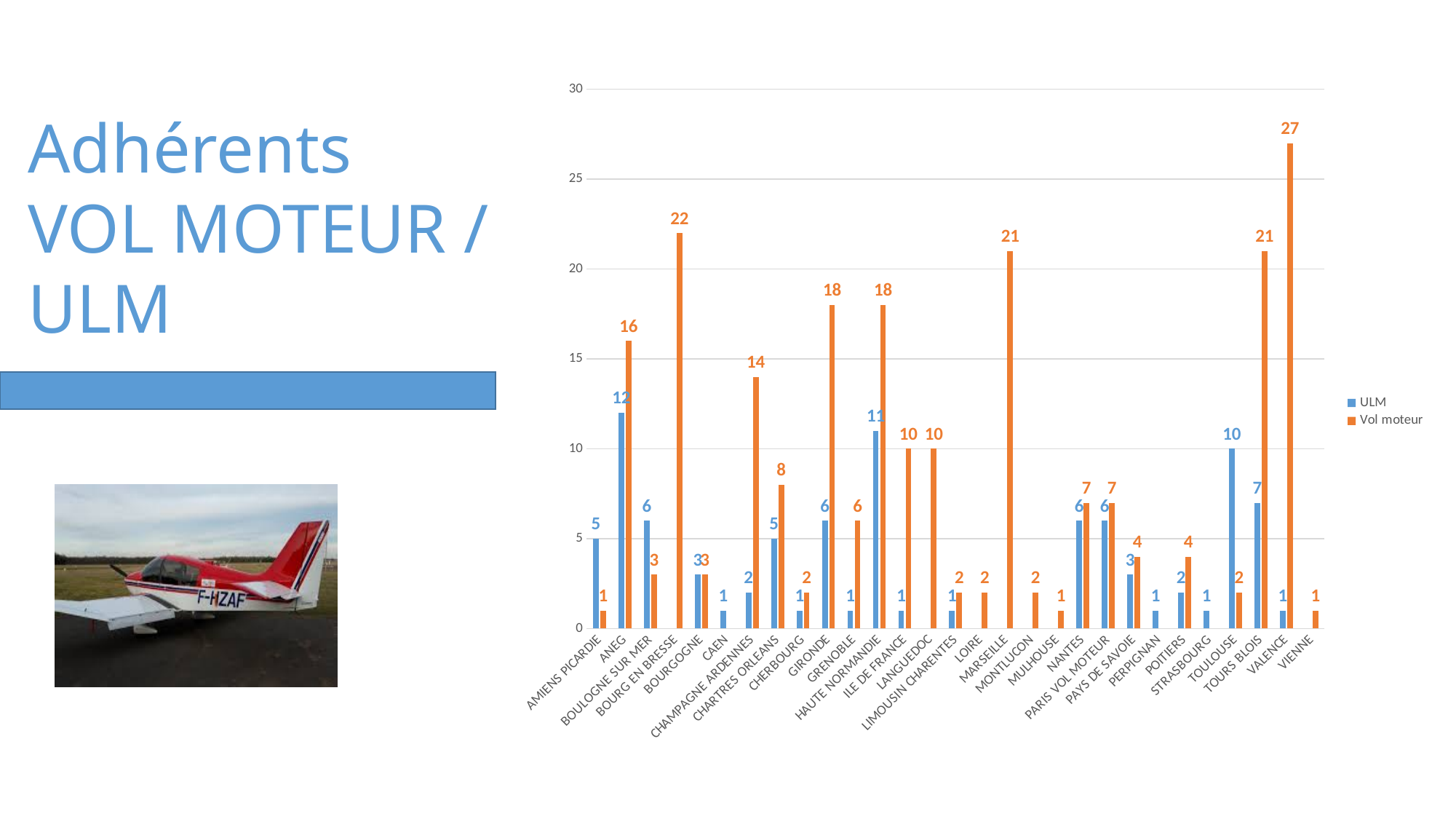
Which category has the highest Vol moteur value? VALENCE What is the Vol moteur value for VALENCE? 27 Which category has the highest ULM value? ANEG What kind of chart is shown on the slide? Bar chart Is the Vol moteur value for MARSEILLE greater or less than 20? greater What is the Vol moteur value for BOURG EN BRESSE? 22 What is the difference between the Vol moteur and ULM values for HAUTE NORMANDIE? 7 Which is larger for TOULOUSE, the ULM value or the Vol moteur value? ULM What is the ULM value for ANEG? 12 What colour are the Vol moteur bars? Orange What is the ULM value for TOULOUSE? 10 How many series does the legend list? 2